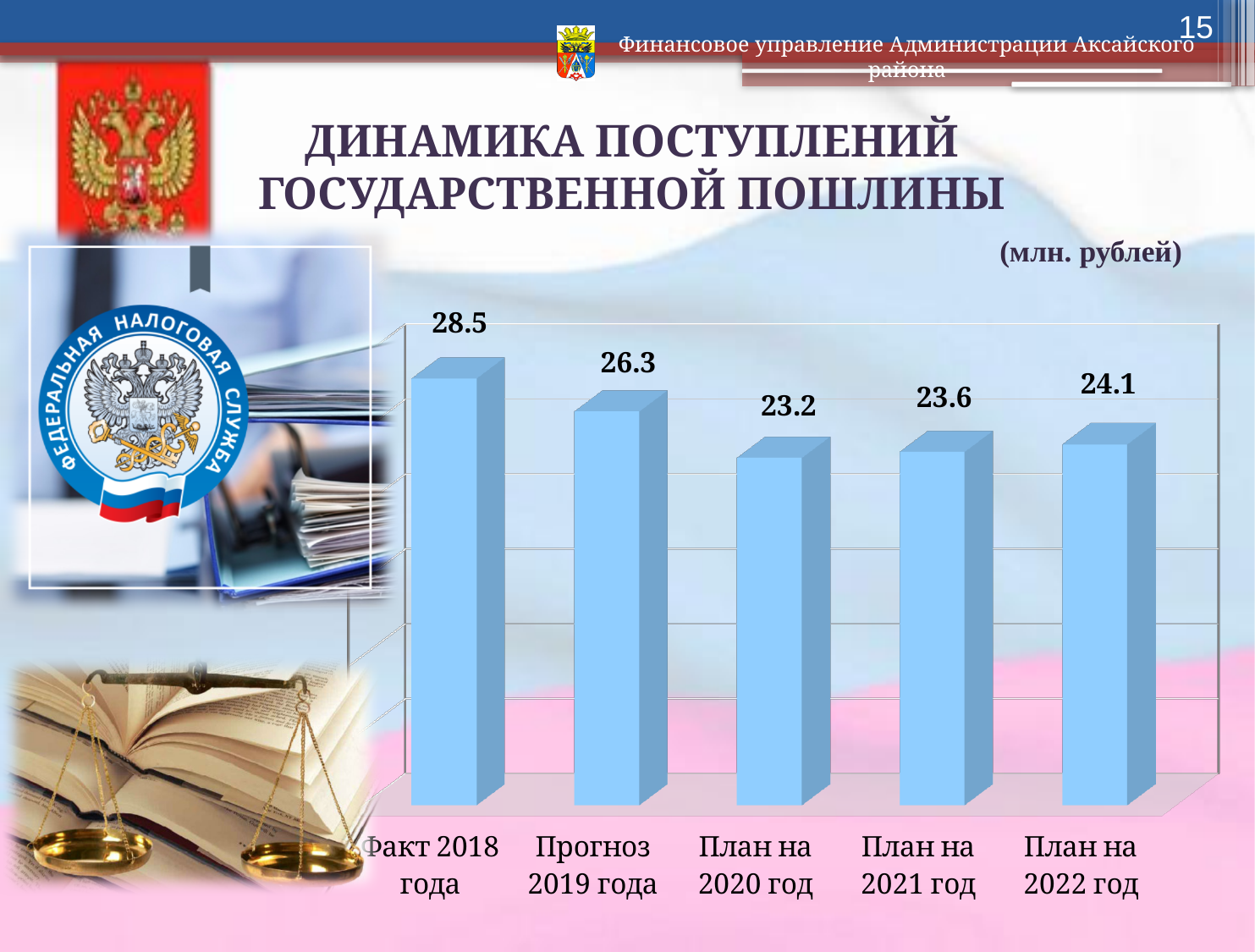
What is the difference between the values for Факт 2018 года and Прогноз 2019 года? 2.2 What is the value for Факт 2018 года? 28.5 What is the value for План на 2022 год? 24.1 Which is larger, the value for План на 2021 год or the value for План на 2020 год? План на 2021 год What is the value for План на 2020 год? 23.2 Which category has the lowest value? План на 2020 год How many categories are shown on the chart? 5 What is the value for Прогноз 2019 года? 26.3 What is the difference between the values for План на 2022 год and План на 2021 год? 0.5 What unit is stated for the chart values? млн. рублей What kind of chart is shown on the slide? bar chart Which category has the highest value? Факт 2018 года